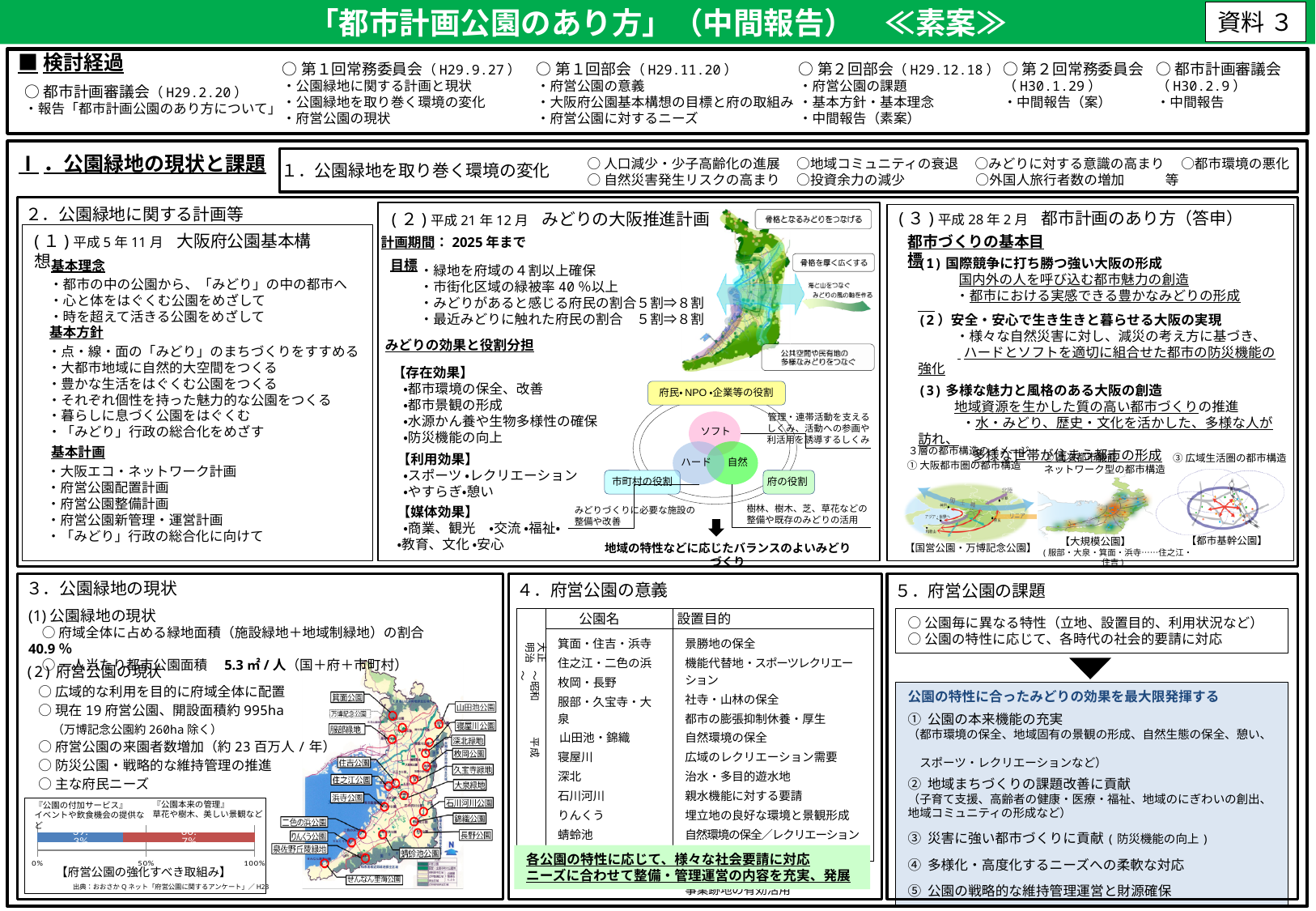
In the 【府営公園の強化すべき取組み】 chart, what is the difference between 『公園本来の管理』 and 『公園の付加サービス』? 21.4% What source is cited below the 【府営公園の強化すべき取組み】 chart? おおさかQネット「府営公園に関するアンケート」／H28 In the 【府営公園の強化すべき取組み】 chart, which is larger: 『公園の付加サービス』 or 『公園本来の管理』? 『公園本来の管理』 In the 【府営公園の強化すべき取組み】 chart, what is the value for 『公園本来の管理』? 60.7% In the 【府営公園の強化すべき取組み】 chart, which segment has the lowest value? 『公園の付加サービス』 What kind of chart is shown under 【府営公園の強化すべき取組み】 at the bottom left of the slide? bar chart In the 【府営公園の強化すべき取組み】 chart, is the value for 『公園本来の管理』 greater or less than 50%? greater How many series does the legend of the 【府営公園の強化すべき取組み】 chart list? 2 In the 【府営公園の強化すべき取組み】 chart, what is the total of the two stacked segments? 100% In the 【府営公園の強化すべき取組み】 chart, is the value for 『公園の付加サービス』 greater or less than 50%? less In the 【府営公園の強化すべき取組み】 chart, which segment has the highest value? 『公園本来の管理』 In the 【府営公園の強化すべき取組み】 chart, what is the value for 『公園の付加サービス』? 39.3%